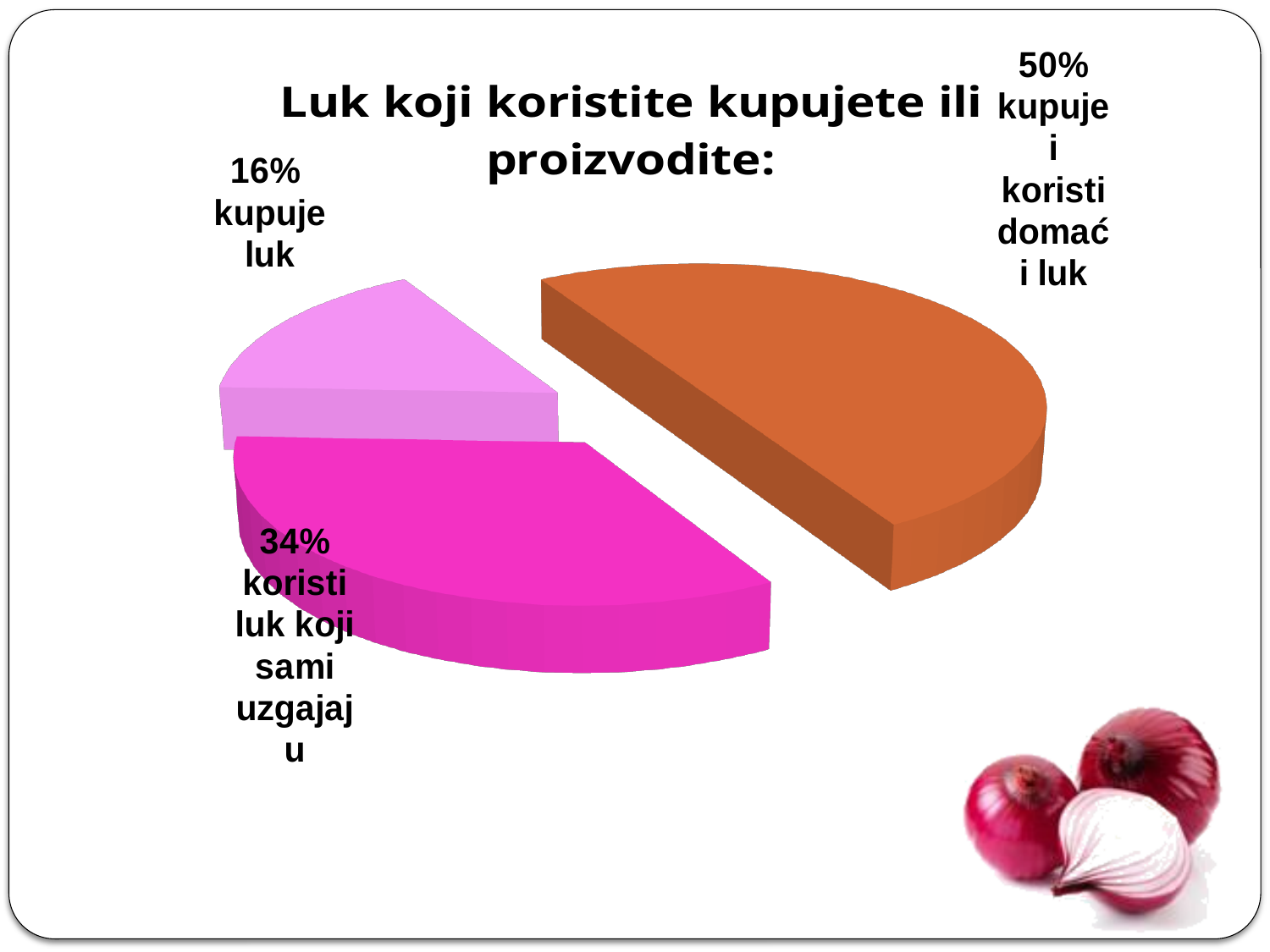
Which category has the smallest share of the pie? kupuje luk What kind of chart is shown on the slide? Pie chart What share of the pie is labelled "kupuje luk"? 16% What is the title of the chart? Luk koji koristite kupujete ili proizvodite: What share of the pie is labelled "koristi luk koji sami uzgajaju"? 34% What share of the pie is labelled "kupuje i koristi domaći luk"? 50% What is the difference in percentage points between "koristi luk koji sami uzgajaju" and "kupuje luk"? 18 Which category has the largest share of the pie? kupuje i koristi domaći luk What colour is the slice for "kupuje i koristi domaći luk"? Orange Which is larger: the share for "kupuje luk" or the share for "koristi luk koji sami uzgajaju"? koristi luk koji sami uzgajaju What is the difference in percentage points between "kupuje i koristi domaći luk" and "koristi luk koji sami uzgajaju"? 16 How many slices does the pie chart have? 3